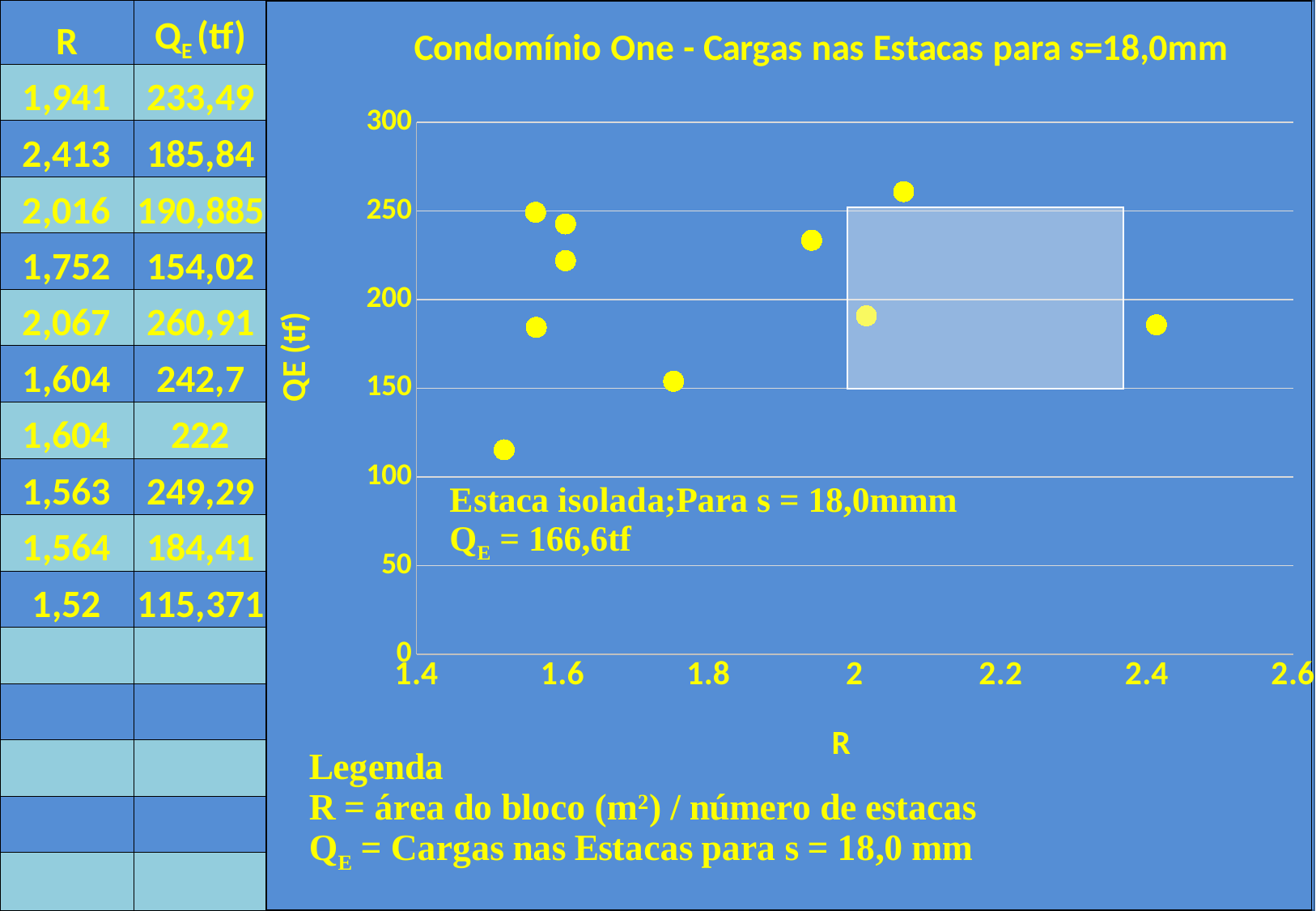
What is the title of the chart? Condomínio One - Cargas nas Estacas para s=18,0mm What is the label of the vertical axis of the chart? QE (tf) What kind of chart is shown on the slide? scatter chart Is the QE value of the point plotted at R of about 1.94 greater or less than 200? greater Is the QE value of the point plotted at R of about 2.4 greater or less than 200? less How many data points are plotted in the chart? 10 Is the QE value of the highest point in the chart greater or less than 250? greater According to the table on the slide, what is the QE value of the highest point in the chart (R = 2,067)? 260,91 According to the table on the slide, what is the QE value of the lowest point in the chart (R = 1,52)? 115,371 Which has the larger QE value: the point at R of about 1.94 or the point at R of about 2.4? the point at R of about 1.94